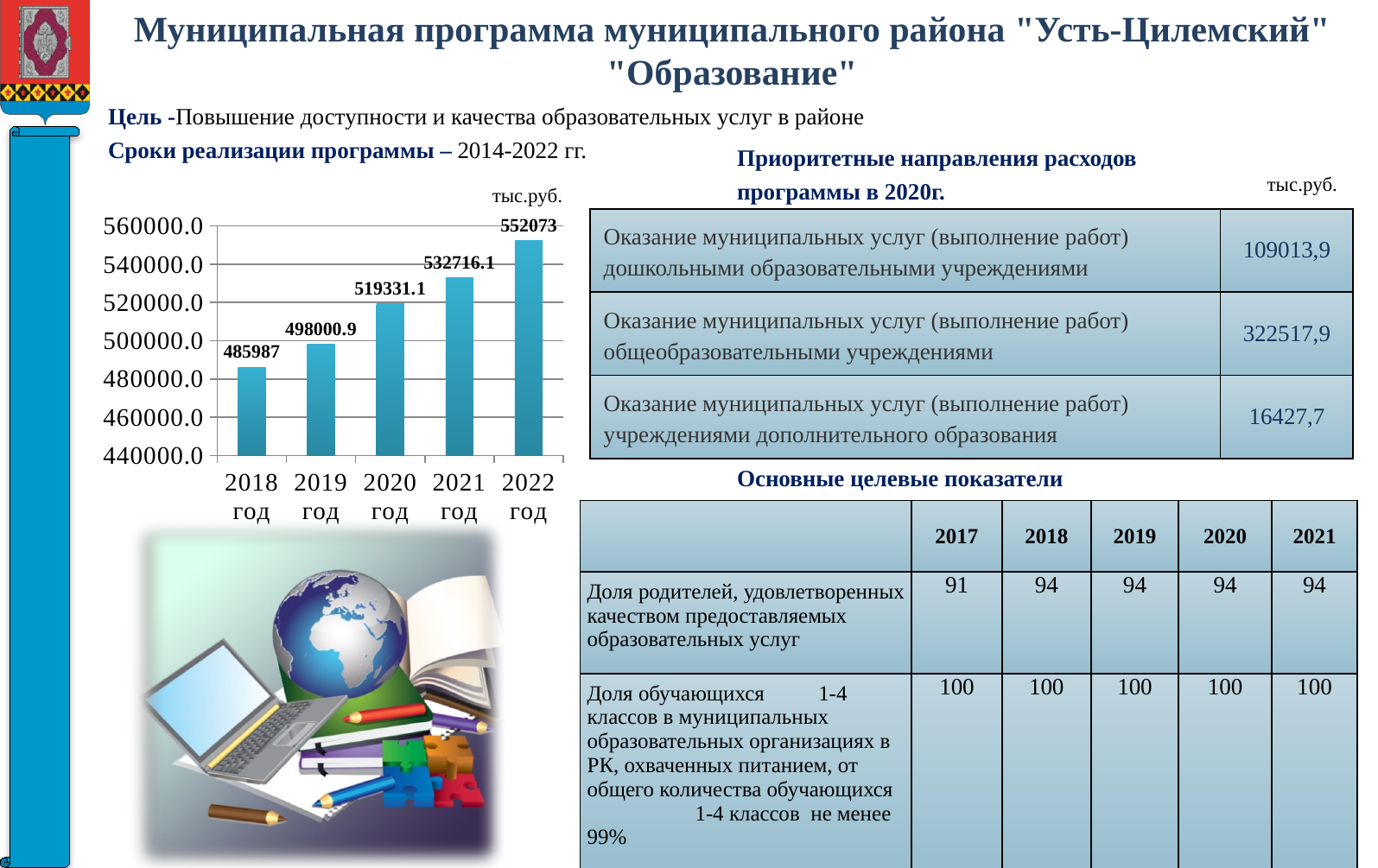
Which year has the lowest value in the bar chart? 2018 год What is the value for 2019 год in the bar chart? 498000.9 What is the value for 2022 год in the bar chart? 552073 How many bars are shown in the bar chart? 5 Which year has the highest value in the bar chart? 2022 год What is the value for 2020 год in the bar chart? 519331.1 What is the value for 2021 год in the bar chart? 532716.1 Which is larger in the bar chart, the value for 2020 год or the value for 2019 год? 2020 год Do the values in the bar chart rise or fall from 2018 год to 2022 год? rise What is the value for 2018 год in the bar chart? 485987 What is the difference between the values for 2022 год and 2018 год in the bar chart? 66086 What type of chart is shown on the slide? bar chart